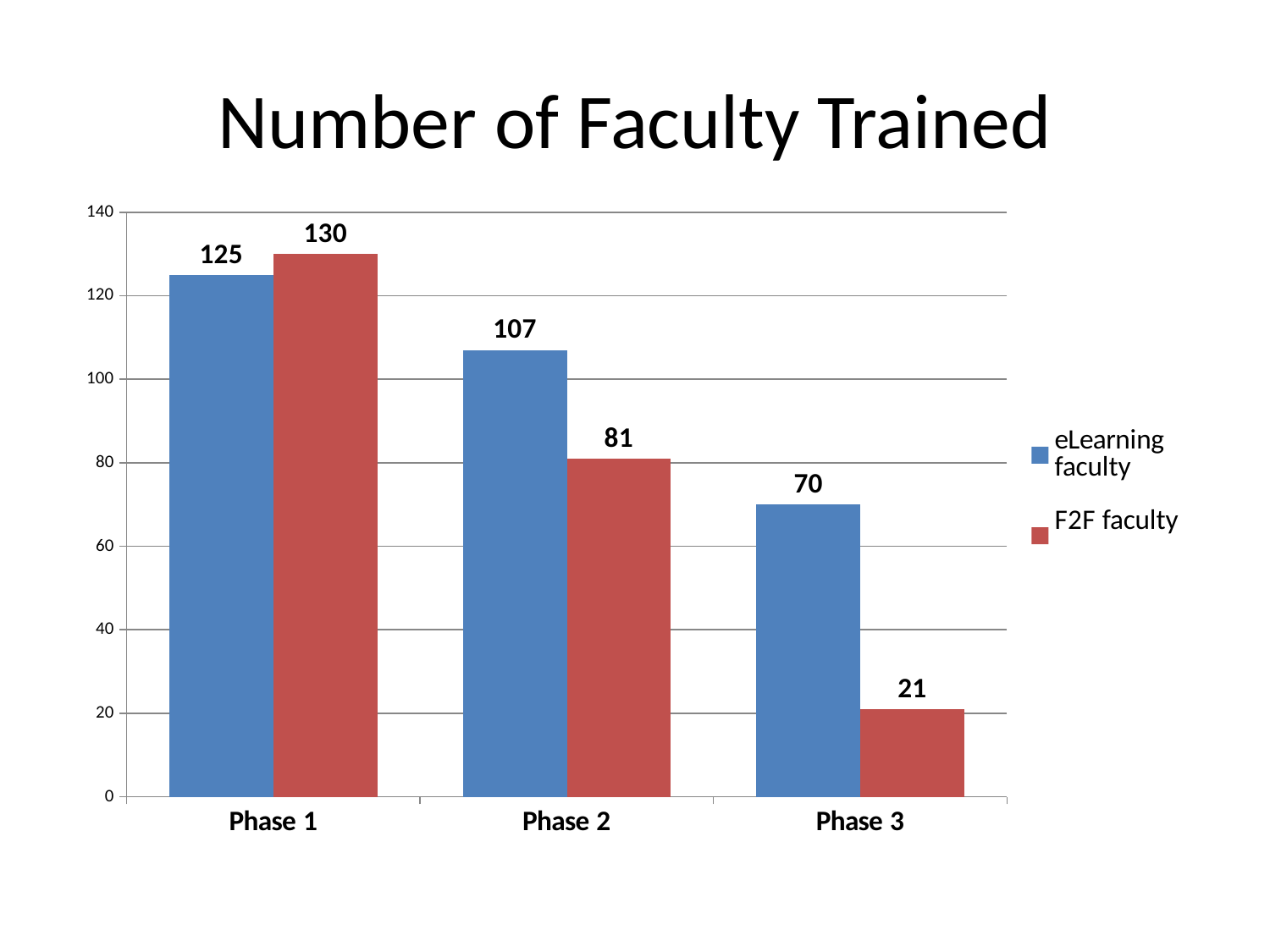
Which phase has the lowest value for F2F faculty? Phase 3 Which phase has the highest value for eLearning faculty? Phase 1 What is the value for F2F faculty in Phase 3? 21 What kind of chart is shown on the slide? Bar chart How many series does the legend list? 2 How many phases are shown on the x axis? 3 What is the value for F2F faculty in Phase 1? 130 Do the F2F faculty values rise or fall from Phase 1 to Phase 3? Fall What is the difference between F2F faculty in Phase 1 and F2F faculty in Phase 3? 109 What is the difference between eLearning faculty and F2F faculty in Phase 2? 26 How many eLearning faculty were trained in Phase 2? 107 Which is larger in Phase 1, eLearning faculty or F2F faculty? F2F faculty